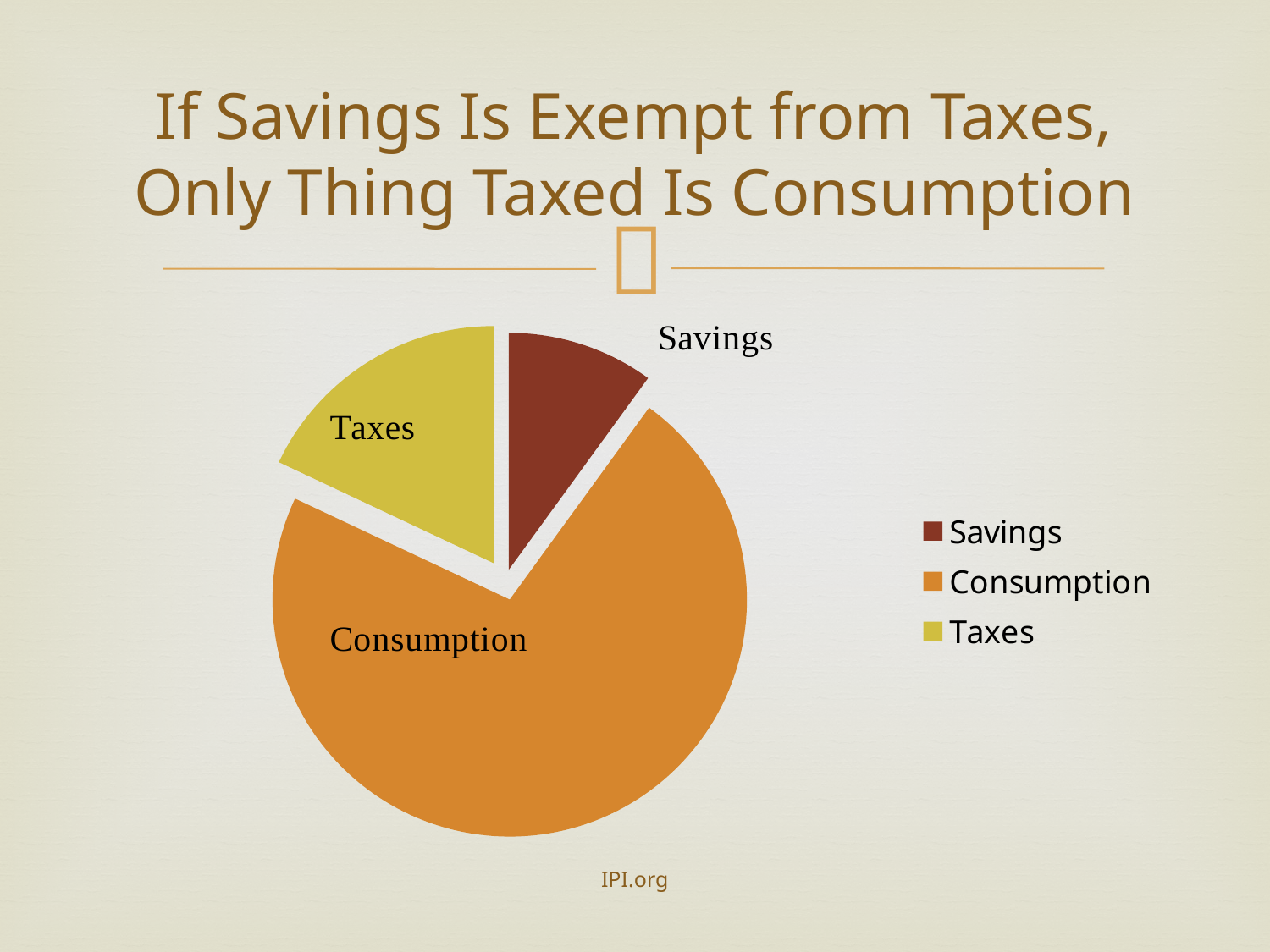
Which slice is larger, Consumption or Taxes? Consumption What kind of chart is shown on the slide? pie chart What colour is the Taxes slice in the pie chart? yellow What is the title of the slide containing the pie chart? If Savings Is Exempt from Taxes, Only Thing Taxed Is Consumption Which category has the largest slice of the pie? Consumption Which slice is larger, Taxes or Savings? Taxes Which category has the smallest slice of the pie? Savings Does the Consumption slice take up more or less than half of the pie? more How many entries does the legend list? 3 How many slices does the pie chart have? 3